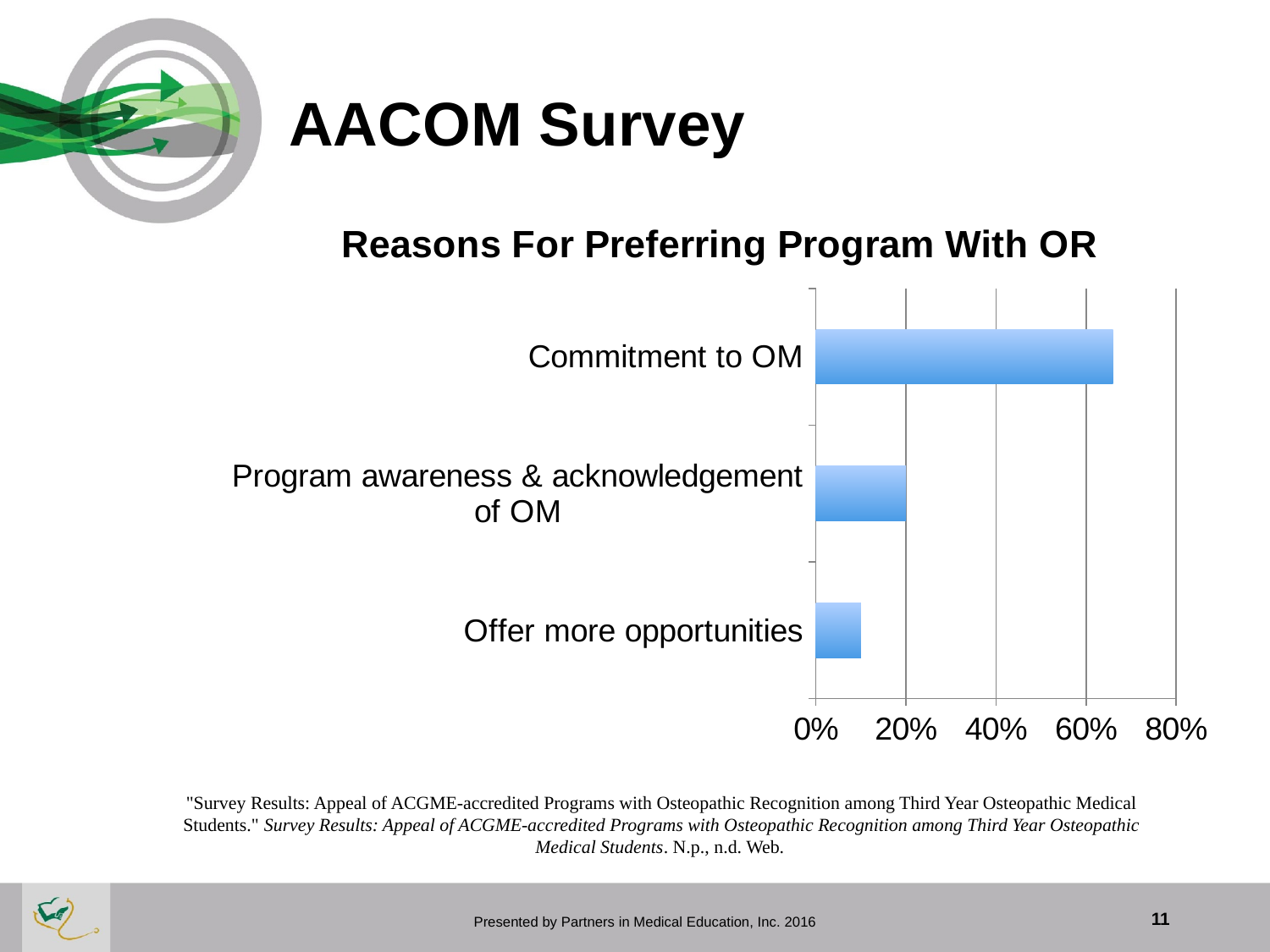
How many categories are shown in the chart? 3 Is the value for Commitment to OM greater or less than 80%? less Which category has the highest value? Commitment to OM What is the highest value shown on the x axis? 80% What kind of chart is shown on the slide? bar chart Which category has the lowest value? Offer more opportunities What is the title of the chart? Reasons For Preferring Program With OR Is the value for Commitment to OM greater or less than 60%? greater What is the value for Program awareness & acknowledgement of OM? 20% Is the value for Offer more opportunities greater or less than 20%? less Which is larger: the value for Program awareness & acknowledgement of OM or the value for Offer more opportunities? Program awareness & acknowledgement of OM Which is larger: the value for Commitment to OM or the value for Program awareness & acknowledgement of OM? Commitment to OM